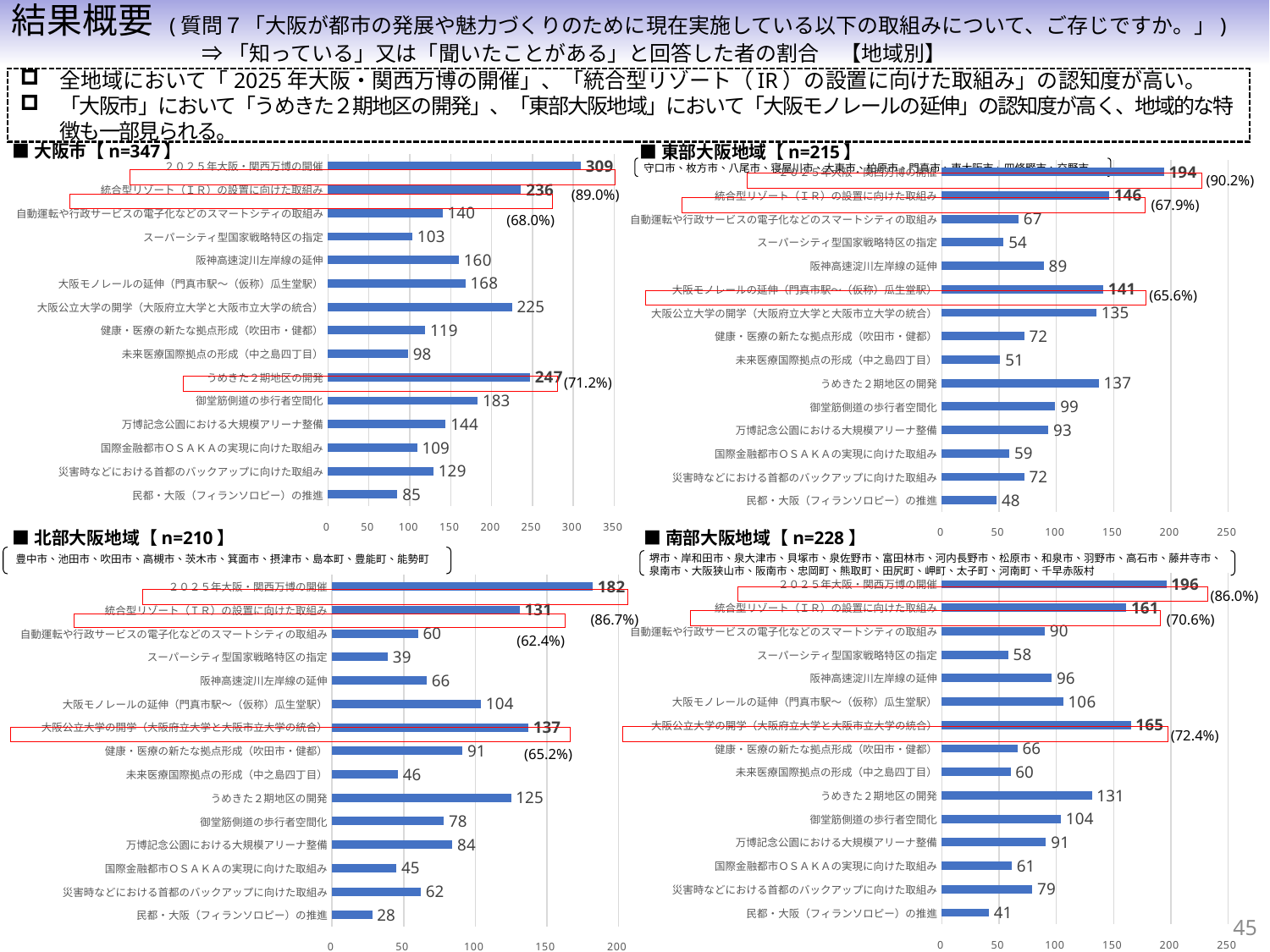
In the 大阪市【n=347】 chart, what is the difference between うめきた２期地区の開発 and 統合型リゾート（ＩＲ）の設置に向けた取組み? 11 In the 東部大阪地域【n=215】 chart, what is the value for 大阪モノレールの延伸（門真市駅～（仮称）瓜生堂駅）? 141 In the 南部大阪地域【n=228】 chart, what is the value for 統合型リゾート（ＩＲ）の設置に向けた取組み? 161 In the 北部大阪地域【n=210】 chart, how many categories are plotted? 15 In the 東部大阪地域【n=215】 chart, which is larger: 阪神高速淀川左岸線の延伸 or 御堂筋側道の歩行者空間化? 御堂筋側道の歩行者空間化 In the 南部大阪地域【n=228】 chart, what is the difference between 2025年大阪・関西万博の開催 and 大阪公立大学の開学（大阪府立大学と大阪市立大学の統合）? 31 In the 北部大阪地域【n=210】 chart, what is the value for 大阪公立大学の開学（大阪府立大学と大阪市立大学の統合）? 137 In the 北部大阪地域【n=210】 chart, what is the value for 民都・大阪（フィランソロピー）の推進? 28 In the 大阪市【n=347】 chart, which category has the lowest value? 民都・大阪（フィランソロピー）の推進 In the 大阪市【n=347】 chart, what is the value for 2025年大阪・関西万博の開催? 309 What type of chart is the 南部大阪地域【n=228】 chart? Bar chart In the 東部大阪地域【n=215】 chart, which category has the highest value? 2025年大阪・関西万博の開催